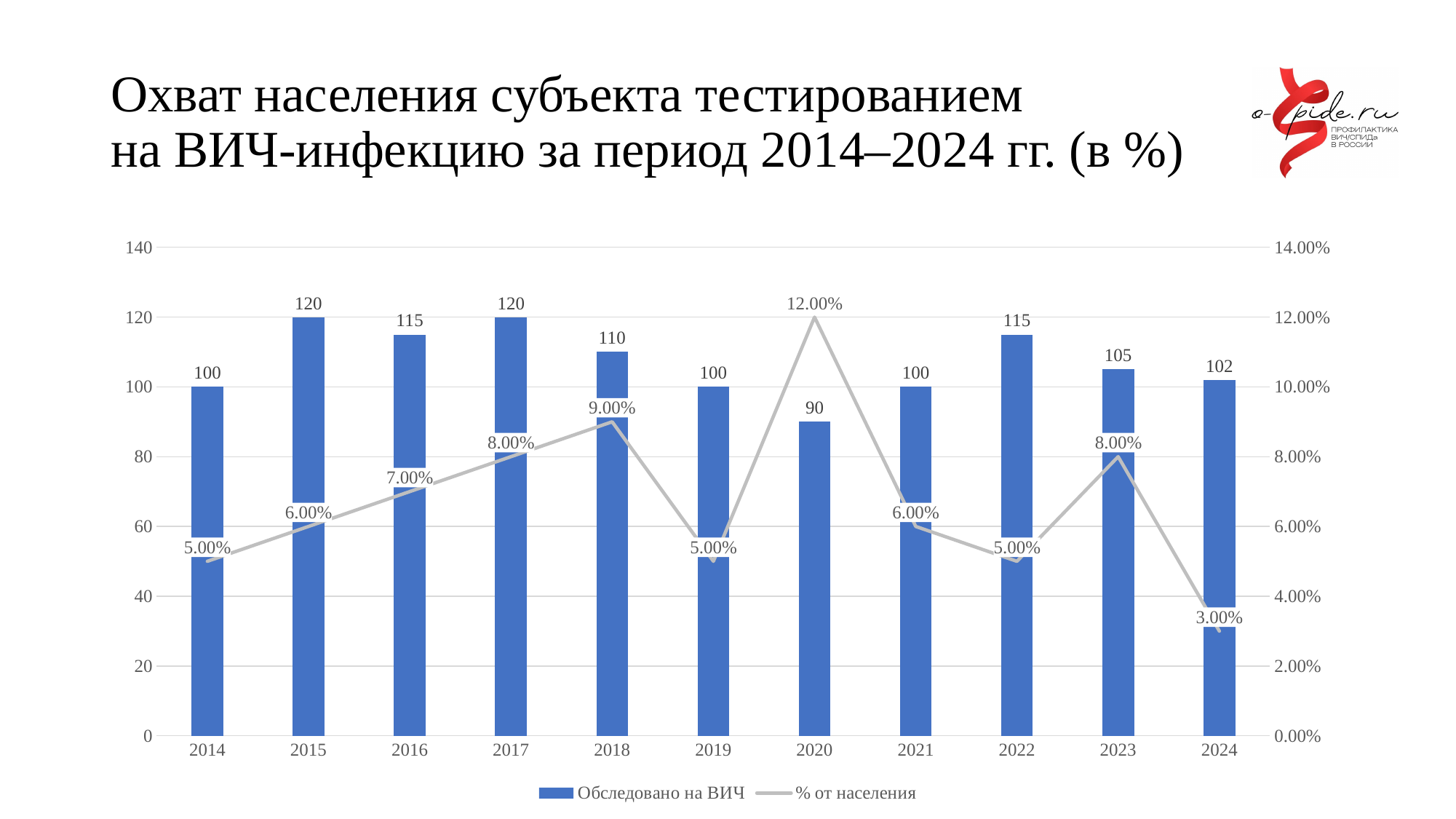
How many years are shown on the x axis? 11 What is the value of "Обследовано на ВИЧ" for 2024? 102 Which year has a larger "Обследовано на ВИЧ" value, 2016 or 2023? 2016 How many series does the legend list? 2 In which year is "Обследовано на ВИЧ" lowest? 2020 Does "% от населения" rise or fall from 2014 to 2018? Rise What is the value of "% от населения" for 2018? 9.00% What is the value of "Обследовано на ВИЧ" for 2020? 90 In which year is "% от населения" highest? 2020 What is the difference between the "Обследовано на ВИЧ" values for 2015 and 2020? 30 In which year is "% от населения" lowest? 2024 What kind of chart is shown on the slide? Combined bar and line chart